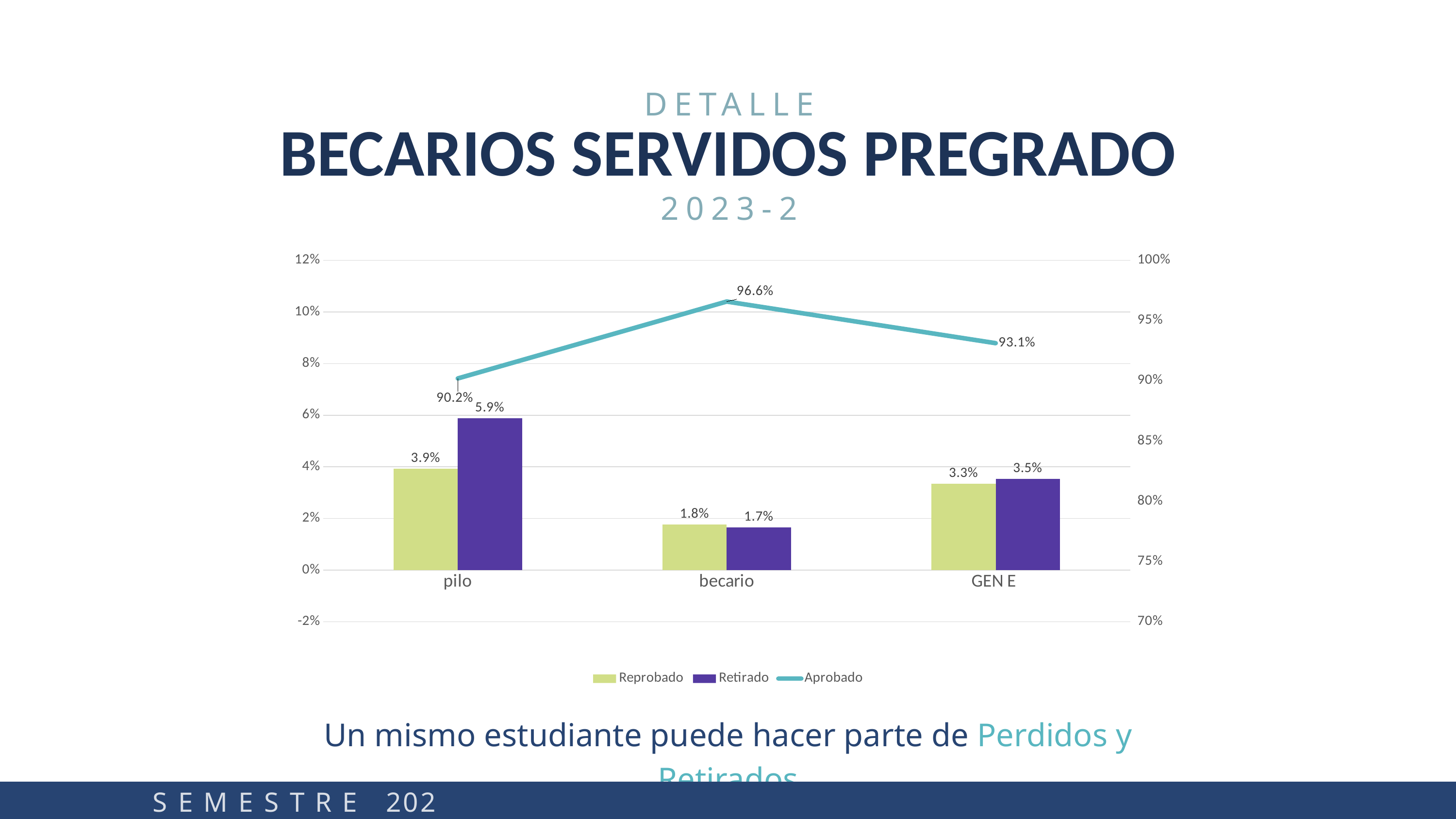
Which is larger for GEN E, the Reprobado value or the Retirado value? Retirado How many categories are shown on the x axis? 3 What is the Aprobado value for GEN E? 93.1% What is the difference between the Retirado and Reprobado values for pilo? 2.0% How many series does the legend list? 3 Is the Aprobado value for pilo greater or less than 95%? less What is the Reprobado value for pilo? 3.9% What is the Retirado value for becario? 1.7% Which category has the lowest Retirado value? becario What kind of chart is shown on the slide? Combined bar and line chart Which category has the highest Aprobado value? becario Which series is plotted as a line rather than bars? Aprobado